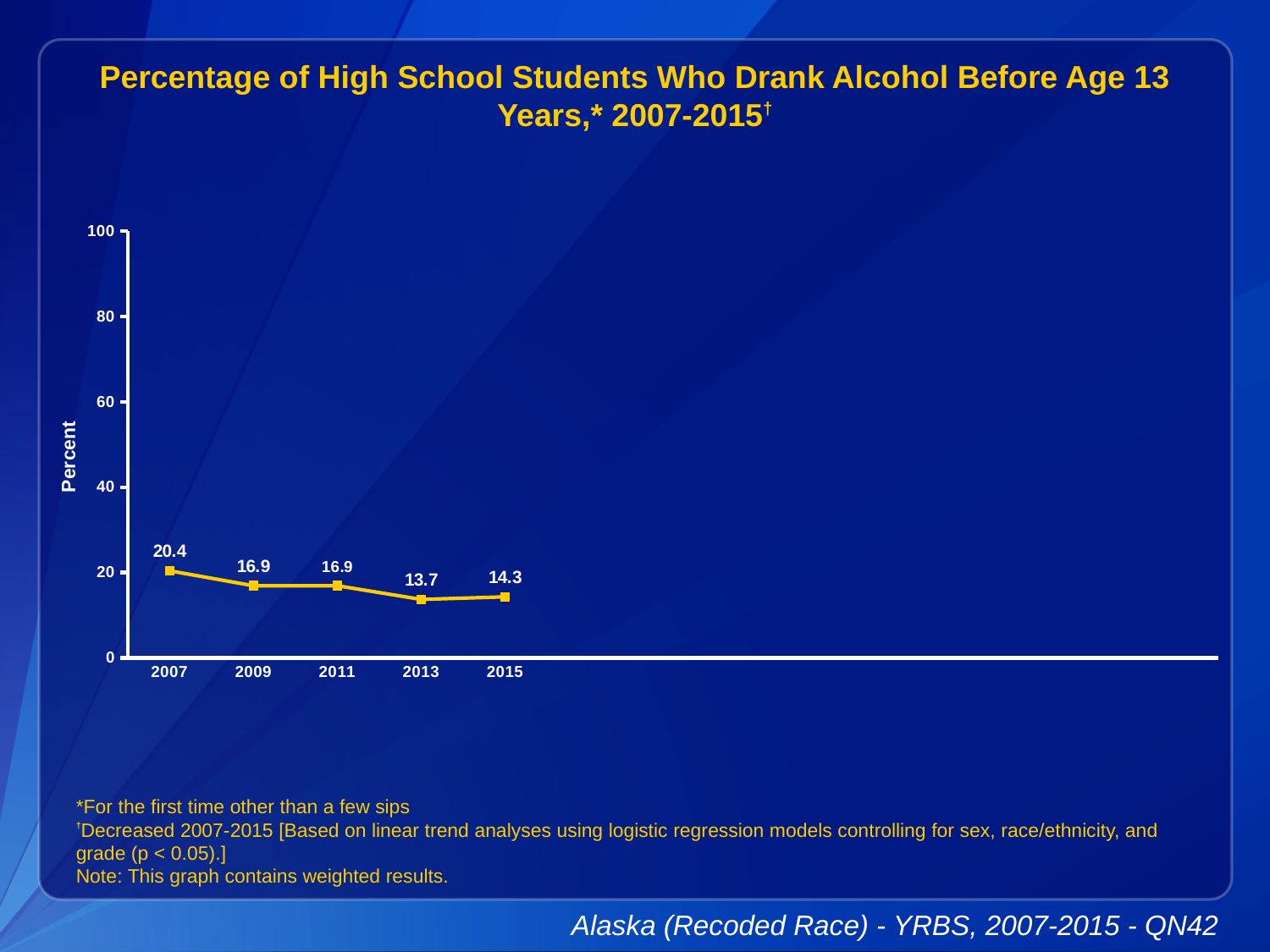
What is the difference between the 2007 value and the 2015 value? 6.1 What is the value plotted for 2015? 14.3 Which is larger, the value for 2013 or the value for 2015? 2015 What is the label on the vertical axis? Percent Which year has the lowest value on the chart? 2013 What kind of chart is shown on the slide? line chart What is the value plotted for 2013? 13.7 How many years are plotted on the chart? 5 Which year has the highest value on the chart? 2007 What is the difference between the 2009 value and the 2013 value? 3.2 Is the value for 2007 greater or less than 40? less What percentage of high school students drank alcohol before age 13 in 2007? 20.4